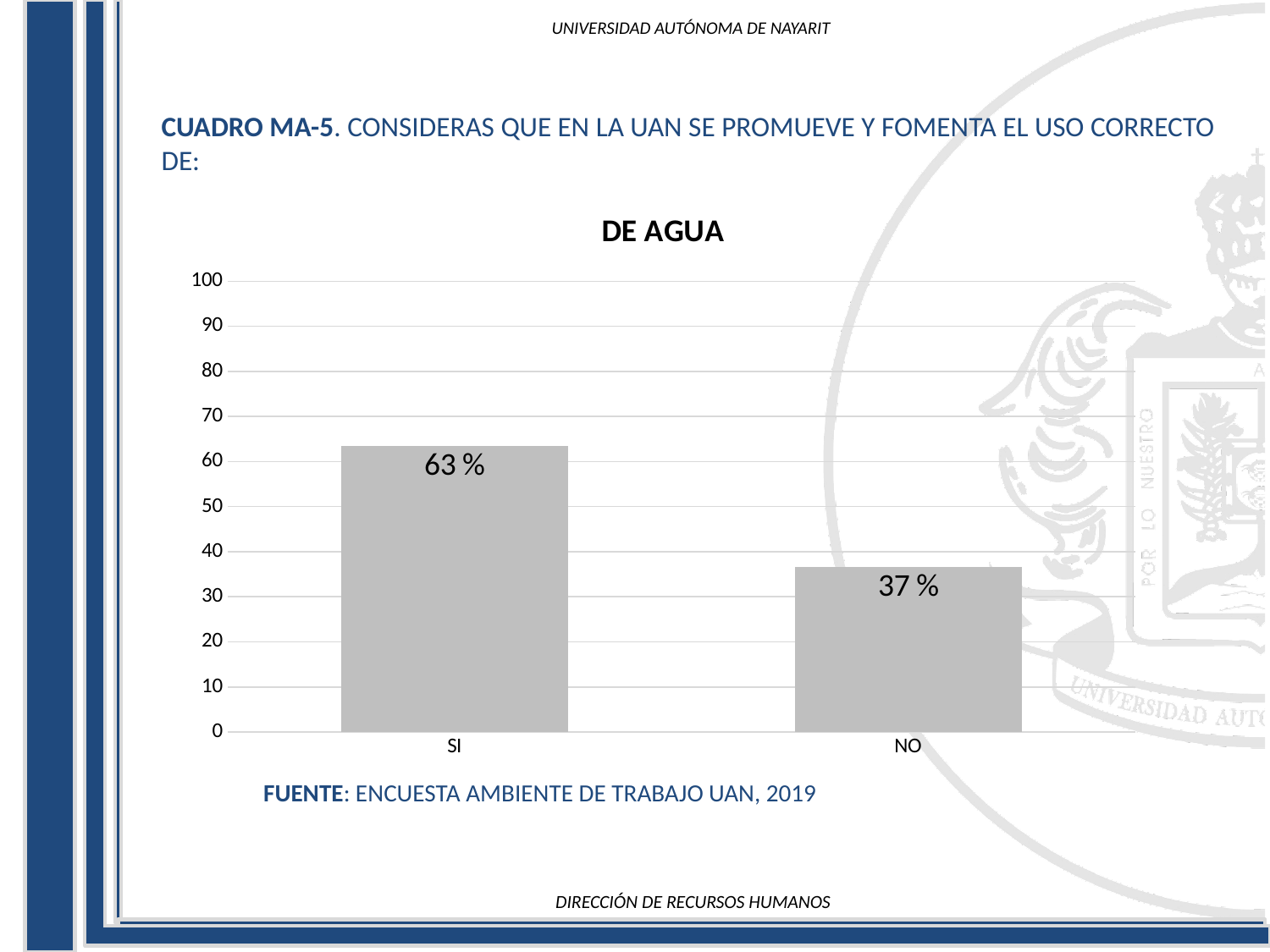
Is the value for NO greater or less than 40? less Is the value for SI greater or less than 50? greater What is the maximum value shown on the y axis? 100 What is the title of the chart? DE AGUA How many categories are shown on the x axis? 2 Which is larger, the value for SI or the value for NO? SI What kind of chart is shown? bar chart Which category has the lowest value? NO What is the value for NO? 37 % What is the difference between the values for SI and NO? 26 % Which category has the highest value? SI What is the value for SI? 63 %